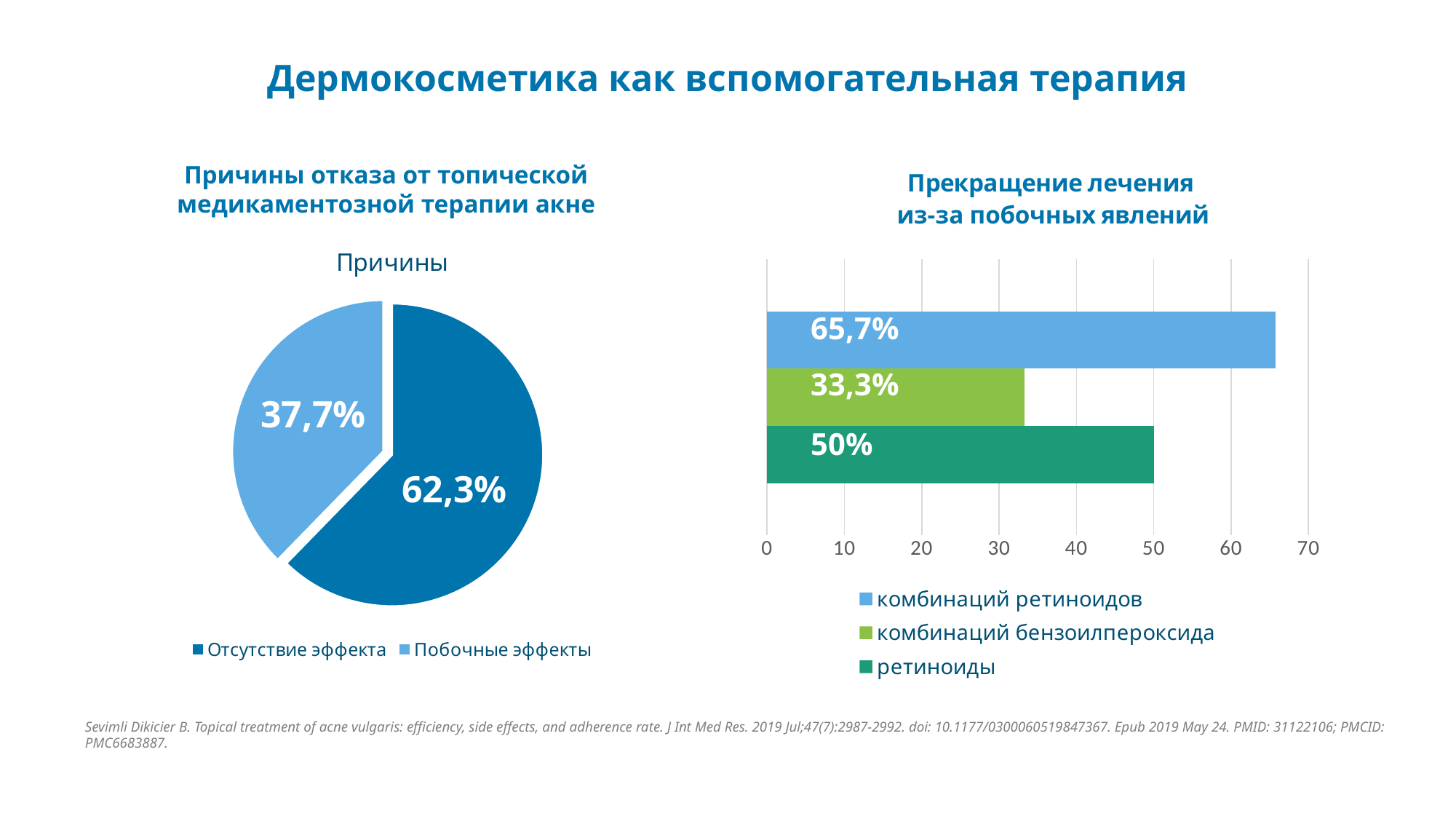
In the pie chart 'Причины' on the left, what is the difference between the 'Отсутствие эффекта' and 'Побочные эффекты' slices? 24,6% In the pie chart 'Причины' on the left, how many slices are there? 2 In the pie chart 'Причины' on the left, which slice is larger: 'Отсутствие эффекта' or 'Побочные эффекты'? Отсутствие эффекта What type of chart is the left chart titled 'Причины'? Pie chart In the bar chart 'Прекращение лечения из-за побочных явлений' on the right, what is the difference between 'комбинаций ретиноидов' and 'комбинаций бензоилпероксида'? 32,4% In the bar chart 'Прекращение лечения из-за побочных явлений' on the right, what is the value for 'ретиноиды'? 50% In the pie chart 'Причины' on the left, what share is labelled for 'Отсутствие эффекта'? 62,3% In the bar chart 'Прекращение лечения из-за побочных явлений' on the right, which series has the highest value? комбинаций ретиноидов In the bar chart 'Прекращение лечения из-за побочных явлений' on the right, which series has the lowest value? комбинаций бензоилпероксида How many series does the legend of the bar chart 'Прекращение лечения из-за побочных явлений' on the right list? 3 In the pie chart 'Причины' on the left, what share is labelled for 'Побочные эффекты'? 37,7% In the bar chart 'Прекращение лечения из-за побочных явлений' on the right, what is the value for 'комбинаций ретиноидов'? 65,7%